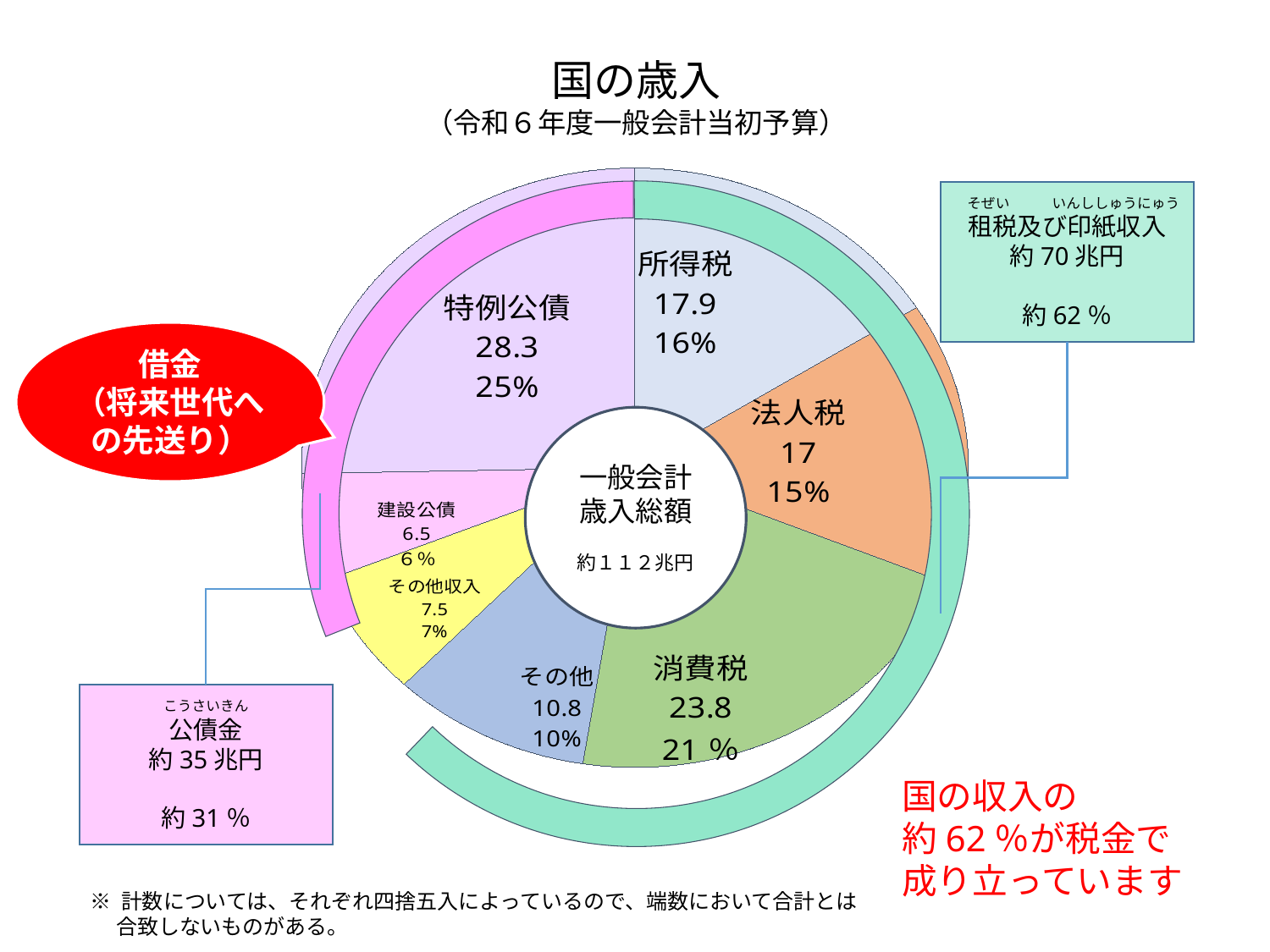
What is the value shown for 特例公債 in the pie chart? 28.3 Which category has the largest slice in the pie chart? 特例公債 How many slices does the pie chart have? 7 What is the value shown for 法人税? 17 What is the title of the chart? 国の歳入 What is the difference between the values for 特例公債 and 消費税? 4.5 What total is shown in the centre of the pie chart? 約１１２兆円 What percentage share does 消費税 have in the pie chart? 21% Which category has the smallest slice in the pie chart? 建設公債 What percentage share does 所得税 have? 16% Which is larger, the value for 所得税 or the value for 法人税? 所得税 What kind of chart is shown on the slide? Pie chart